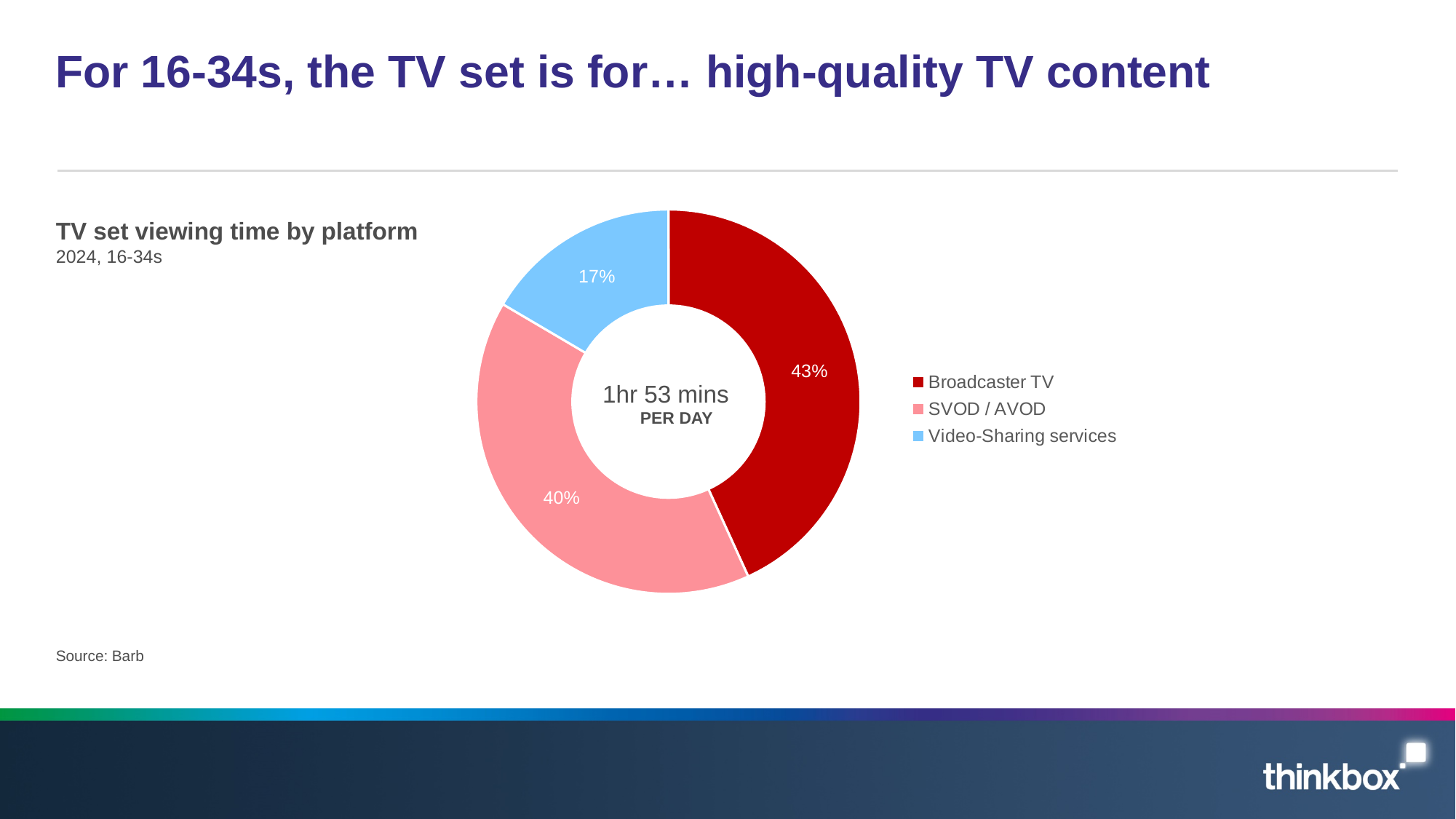
What share of TV set viewing time is SVOD / AVOD? 40% What is the difference in percentage points between the Broadcaster TV share and the Video-Sharing services share? 26 percentage points Which platform has the largest share of TV set viewing time? Broadcaster TV What share of TV set viewing time is Broadcaster TV? 43% Which has a larger share of TV set viewing time, SVOD / AVOD or Video-Sharing services? SVOD / AVOD What is the title of the chart? TV set viewing time by platform Which platform has the smallest share of TV set viewing time? Video-Sharing services How many platforms are shown in the chart? 3 What share of TV set viewing time is Video-Sharing services? 17% What is the difference in percentage points between the SVOD / AVOD share and the Video-Sharing services share? 23 percentage points What kind of chart is shown on the slide? Doughnut (pie) chart What total daily viewing time is shown in the centre of the chart? 1hr 53 mins per day